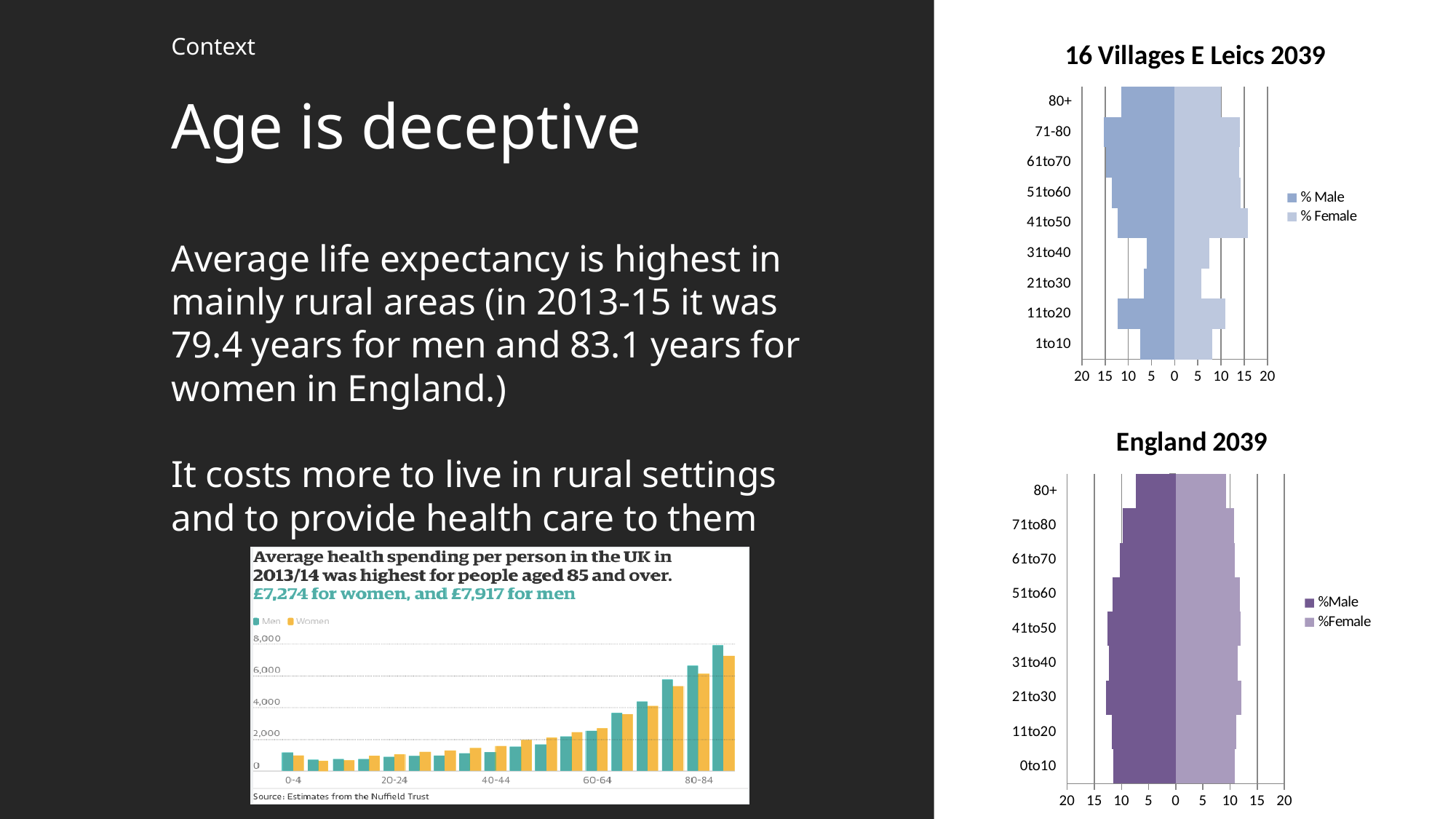
In the health spending chart at the bottom left, what is the difference between spending for men and women aged 85 and over? £643 What kind of chart is the '16 Villages E Leics 2039' chart? bar chart How many age categories are shown on the 'England 2039' chart? 9 In the '16 Villages E Leics 2039' chart, which age group has the largest % Female bar? 41to50 In the '16 Villages E Leics 2039' chart, is the % Male value for 21to30 greater or less than 10? less How many age categories are shown on the '16 Villages E Leics 2039' chart? 9 What are the two legend entries on the 'England 2039' chart? %Male and %Female In the 'England 2039' chart, is the %Male value for 80+ greater or less than 10? less How many series does the legend of the '16 Villages E Leics 2039' chart list? 2 In the health spending chart at the bottom left, what was the average health spending per person for men aged 85 and over in 2013/14? £7,917 In the health spending chart at the bottom left, do the values generally rise or fall as age increases? rise In the '16 Villages E Leics 2039' chart, which is larger for the 71-80 age group, % Male or % Female? % Male